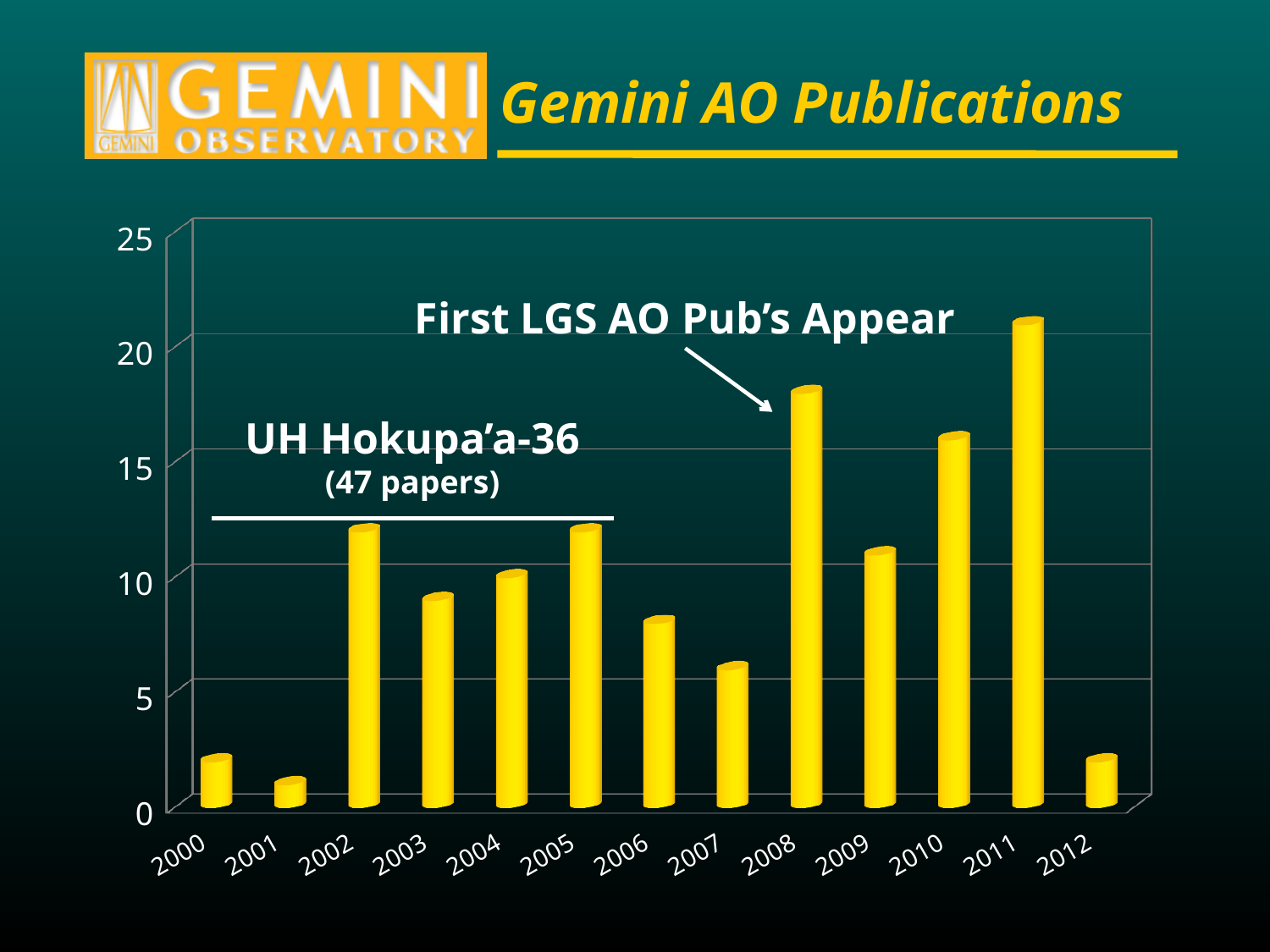
Is the value for 2007 greater or less than 5? greater How many years are shown on the x axis of the chart? 13 Which year has the highest bar in the chart? 2011 Which year has the larger value, 2008 or 2010? 2008 What kind of chart is shown on the slide? bar chart Is the value for 2008 greater or less than 15? greater What is the title of the slide's chart? Gemini AO Publications Is the value for 2001 greater or less than 5? less Which year has the lowest bar in the chart? 2001 Which year has the larger value, 2006 or 2007? 2006 According to the annotation on the chart, how many papers are attributed to UH Hokupa'a-36? 47 papers